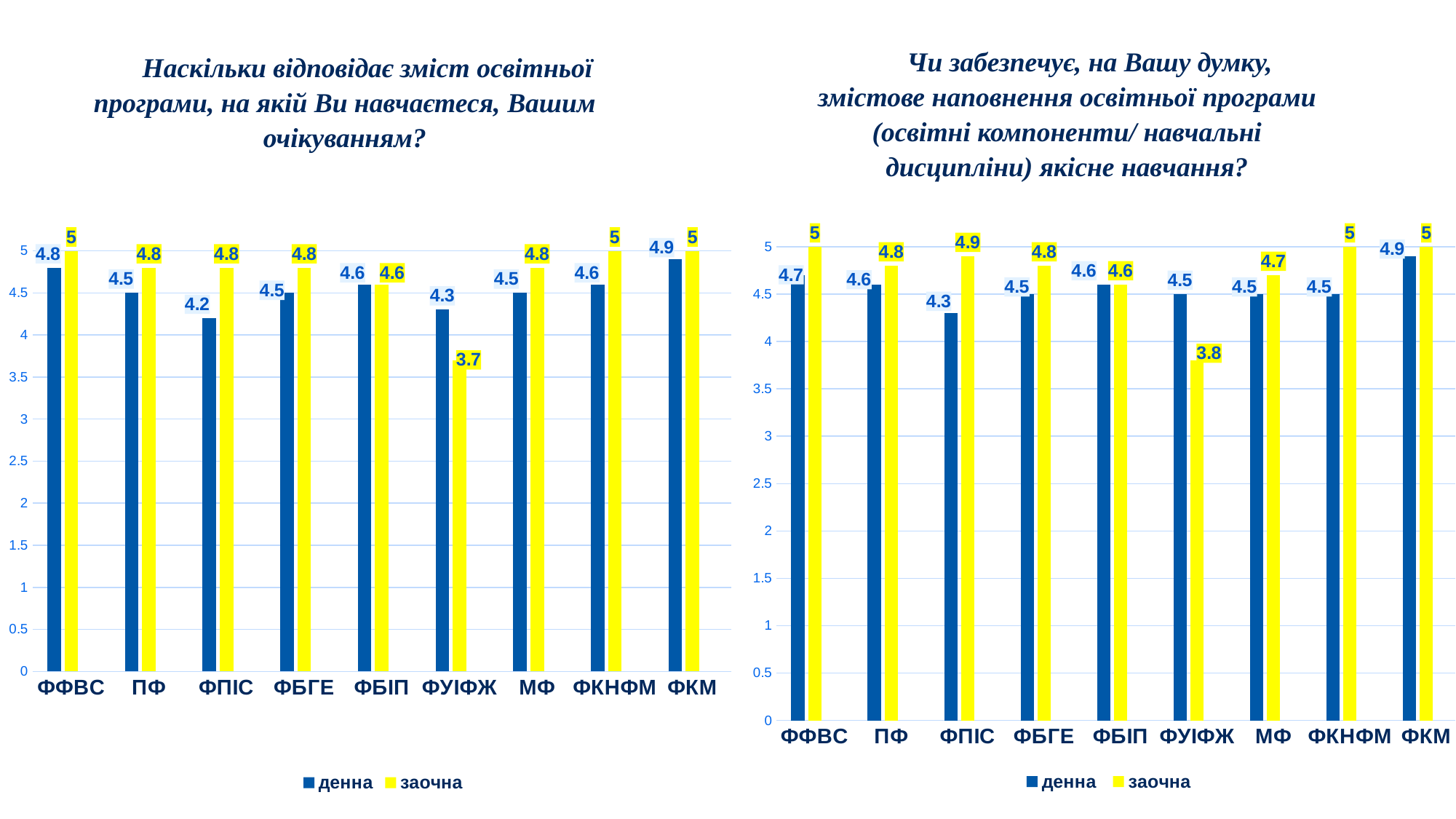
In the right chart, what is the value for денна at ФФВС? 4.7 In the right chart, which is larger at МФ: денна or заочна? заочна In the left chart, what is the value for заочна at ФУІФЖ? 3.7 What type of chart is the left chart? bar chart In the left chart, which category has the highest денна value? ФКМ In the right chart, which category has the lowest денна value? ФПІС In the left chart, which category has the lowest заочна value? ФУІФЖ How many categories are shown on the x axis of the right chart? 9 In the right chart, what is the value for заочна at ФПІС? 4.9 How many series does the legend of the left chart list? 2 In the left chart, what is the value for денна at ФПІС? 4.2 In the left chart, what is the difference between the заочна and денна values at ФУІФЖ? 0.6